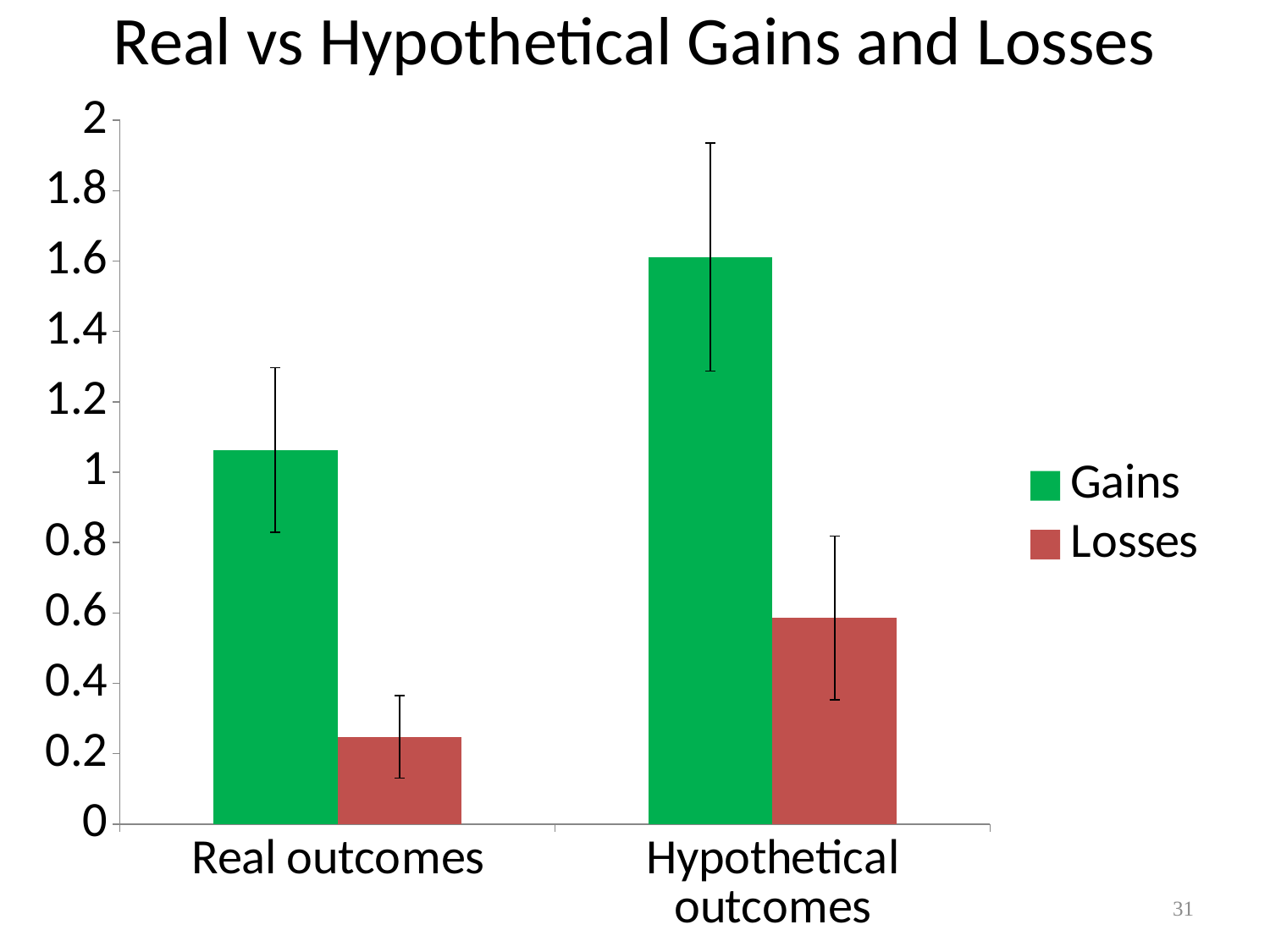
For Real outcomes, which is larger, Gains or Losses? Gains Which category has the lowest Losses value? Real outcomes Is the Losses value for Real outcomes greater or less than 0.4? less Which colour represents the Losses series in the legend? red How many series does the legend list? 2 Is the Gains value for Real outcomes greater or less than 1? greater How many categories are shown on the x axis? 2 What is the title of the chart? Real vs Hypothetical Gains and Losses Is the Losses value for Hypothetical outcomes greater or less than 0.8? less Which category has the highest Gains value? Hypothetical outcomes What kind of chart is shown on the slide? bar chart